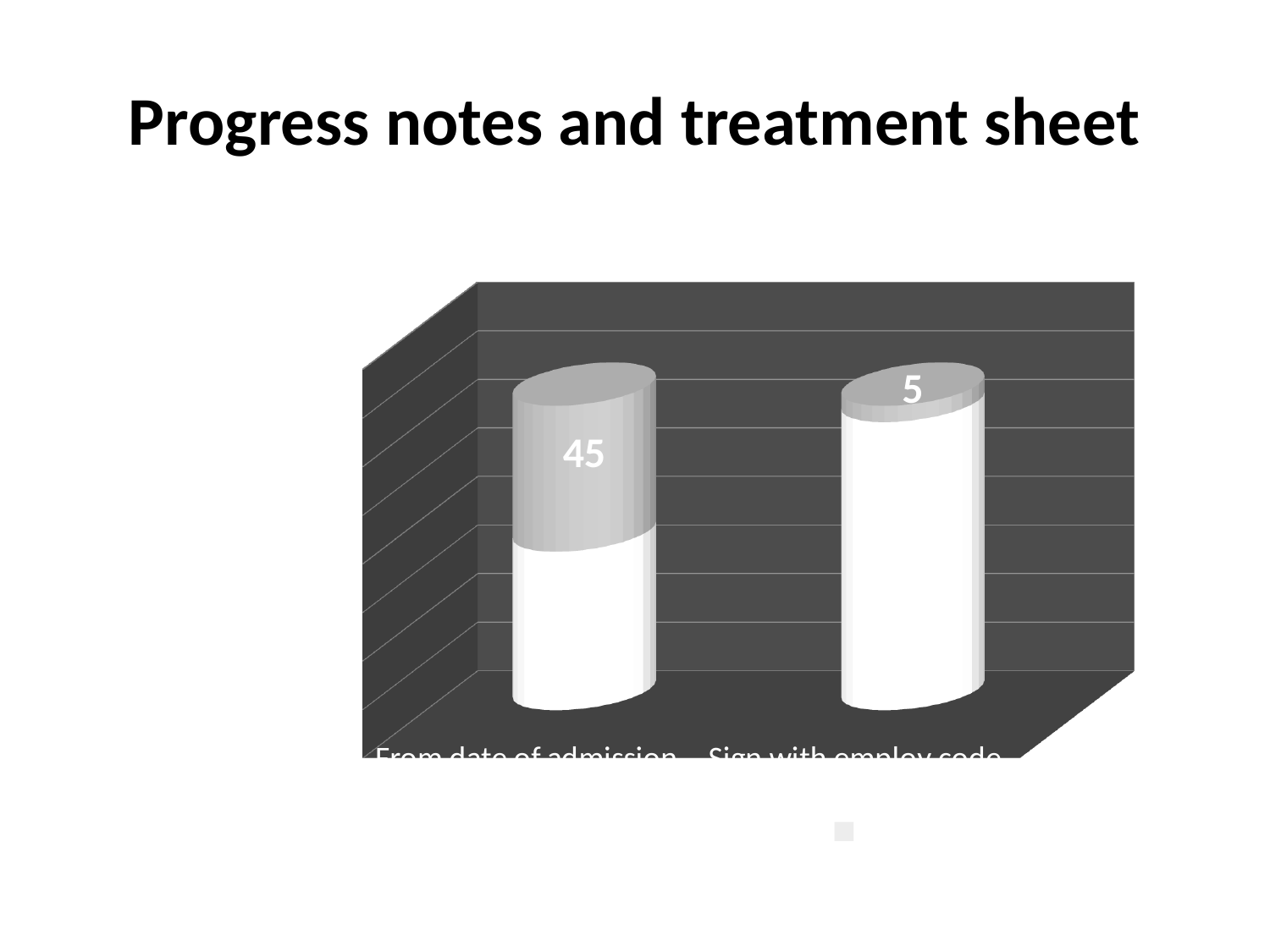
What is the value for Sign with employ code? 5 Do the values rise or fall from the first category to the second? Fall What is the value for From date of admission? 45 What is the title of the slide containing the chart? Progress notes and treatment sheet Which is larger, the value for From date of admission or the value for Sign with employ code? From date of admission What is the difference between the values for From date of admission and Sign with employ code? 40 What kind of chart is shown on the slide? Bar chart Which category has the highest value? From date of admission How many categories are shown in the chart? 2 Which category has the lowest value? Sign with employ code